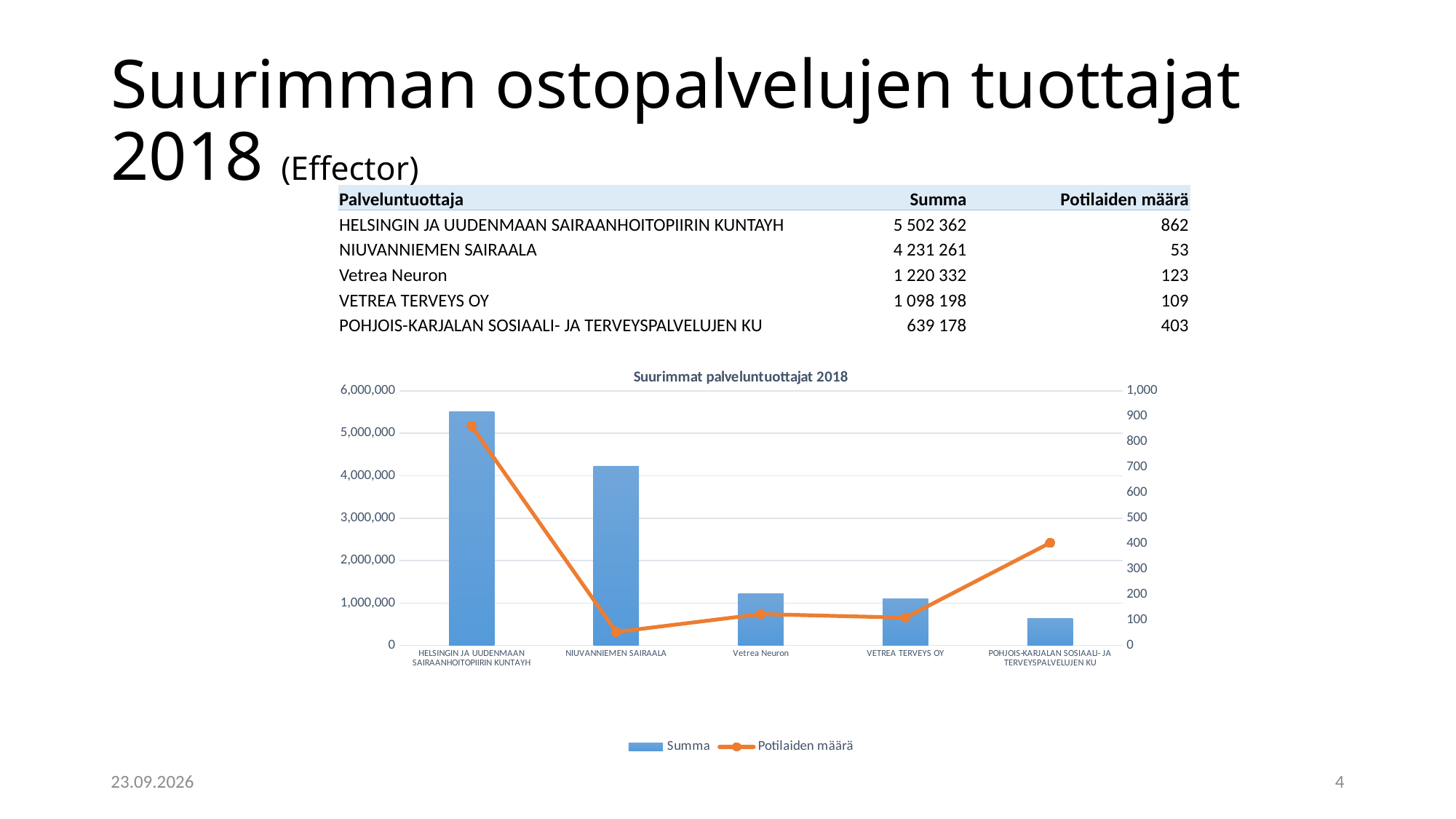
Which provider has the lowest Potilaiden määrä in the chart? NIUVANNIEMEN SAIRAALA How many series does the legend of the chart list? 2 Which provider has the highest Summa in the chart? HELSINGIN JA UUDENMAAN SAIRAANHOITOPIIRIN KUNTAYH Which is larger, the Potilaiden määrä for Vetrea Neuron or for VETREA TERVEYS OY? Vetrea Neuron Which series in the chart is drawn as an orange line with markers? Potilaiden määrä How many service providers are shown on the x axis of the chart? 5 What is the Summa for NIUVANNIEMEN SAIRAALA? 4 231 261 What is the difference in Potilaiden määrä between HELSINGIN JA UUDENMAAN SAIRAANHOITOPIIRIN KUNTAYH and NIUVANNIEMEN SAIRAALA? 809 Which provider has the lowest Summa in the chart? POHJOIS-KARJALAN SOSIAALI- JA TERVEYSPALVELUJEN KU What kind of chart is 'Suurimmat palveluntuottajat 2018'? A combination bar and line chart Is the Summa bar for Vetrea Neuron greater or less than 2,000,000? less What is the Potilaiden määrä for POHJOIS-KARJALAN SOSIAALI- JA TERVEYSPALVELUJEN KU? 403